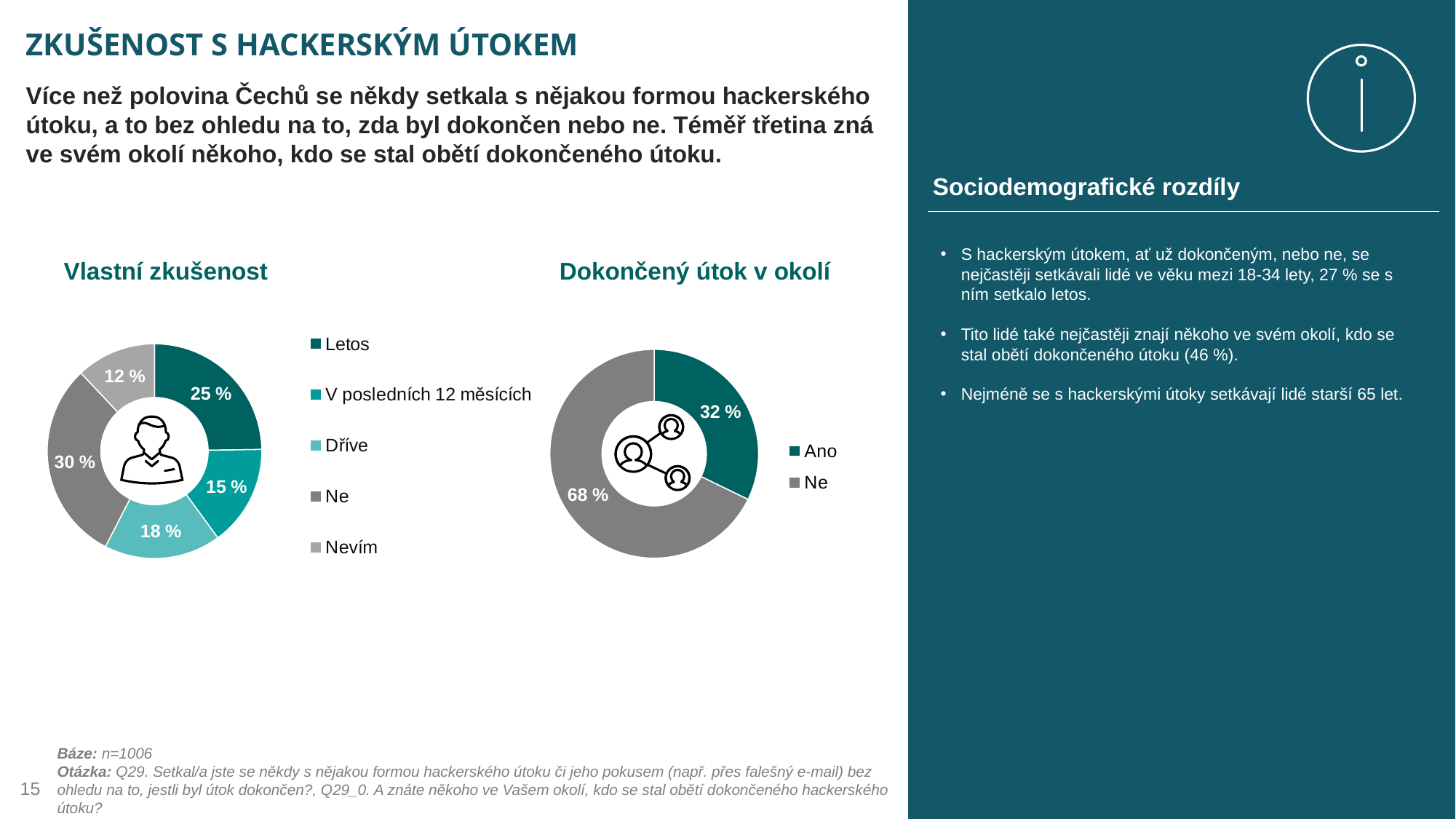
In the 'Dokončený útok v okolí' chart, what is the difference between the shares for 'Ne' and 'Ano'? 36 % In the 'Vlastní zkušenost' chart, which is larger: the share for 'Dříve' or the share for 'Nevím'? Dříve In the 'Dokončený útok v okolí' chart, what share is labelled for 'Ne'? 68 % In the 'Vlastní zkušenost' chart, which category has the smallest share? Nevím In the 'Vlastní zkušenost' chart, what share is labelled for 'Dříve'? 18 % In the 'Vlastní zkušenost' chart, what share is labelled for 'Ne'? 30 % In the 'Dokončený útok v okolí' chart, what share is labelled for 'Ano'? 32 % In the 'Vlastní zkušenost' chart, what share is labelled for 'Letos'? 25 % How many categories does the legend of the 'Vlastní zkušenost' chart list? 5 What kind of chart is the 'Dokončený útok v okolí' chart? Pie (donut) chart In the 'Vlastní zkušenost' chart, what is the difference between the shares for 'Letos' and 'V posledních 12 měsících'? 10 % In the 'Vlastní zkušenost' chart, which category has the largest share? Ne